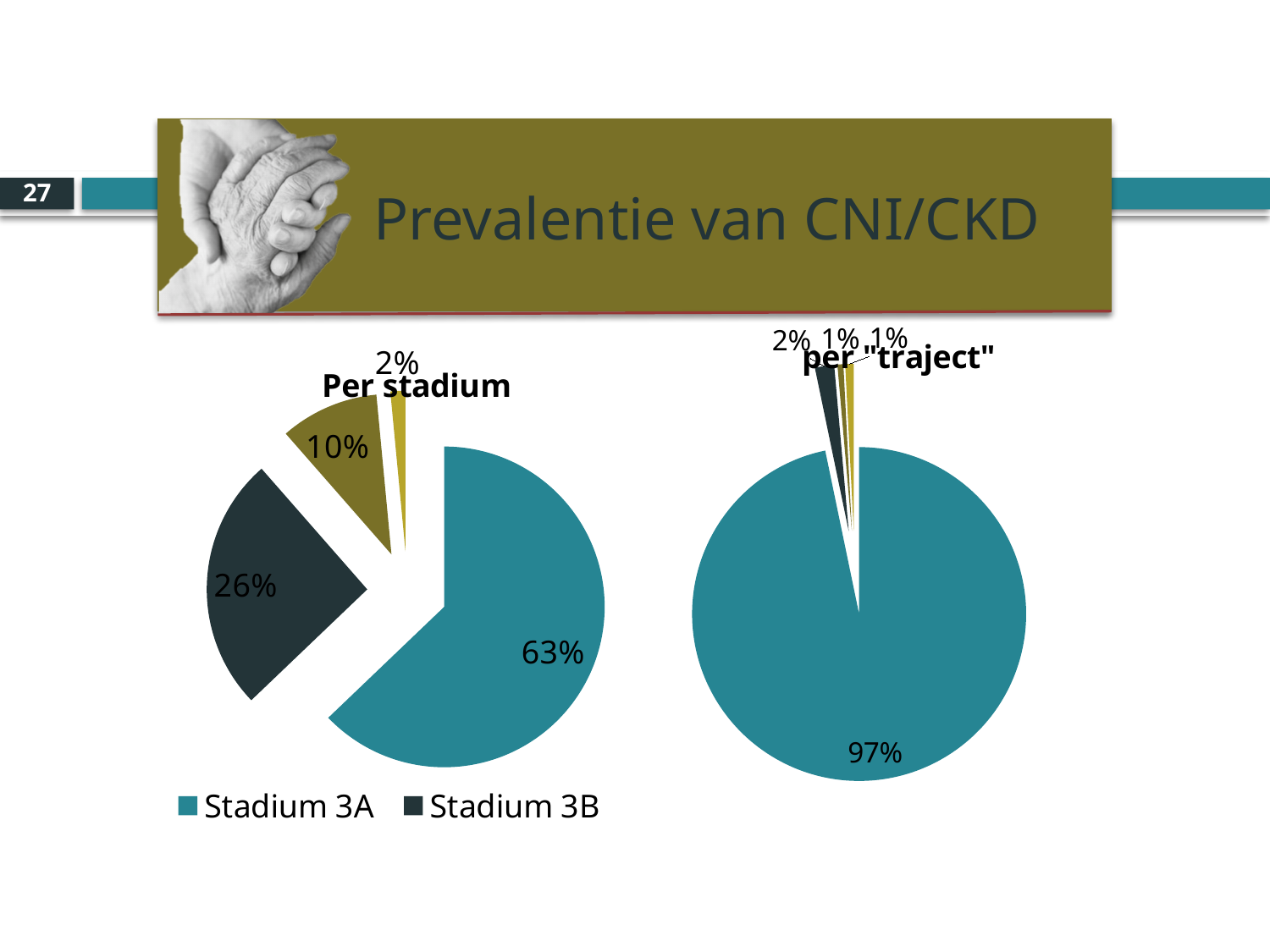
What is the largest percentage shown in the "per traject" chart on the right? 97% How many entries does the legend below the "Per stadium" chart list? 2 In the "Per stadium" chart, which is larger, the Stadium 3A slice or the Stadium 3B slice? Stadium 3A What is the smallest percentage shown in the "Per stadium" chart? 2% What is the title of the chart on the right? per "traject" In the "Per stadium" chart, what share does Stadium 3B have? 26% How many slices does the "Per stadium" chart have? 4 In the "Per stadium" chart, which legend category has the largest slice? Stadium 3A What kind of chart is the "Per stadium" chart on the left? pie chart In the "Per stadium" chart, what is the difference in percentage points between the Stadium 3A and Stadium 3B slices? 37 How many slices does the "per traject" chart on the right have? 4 In the "Per stadium" chart, what share does Stadium 3A have? 63%